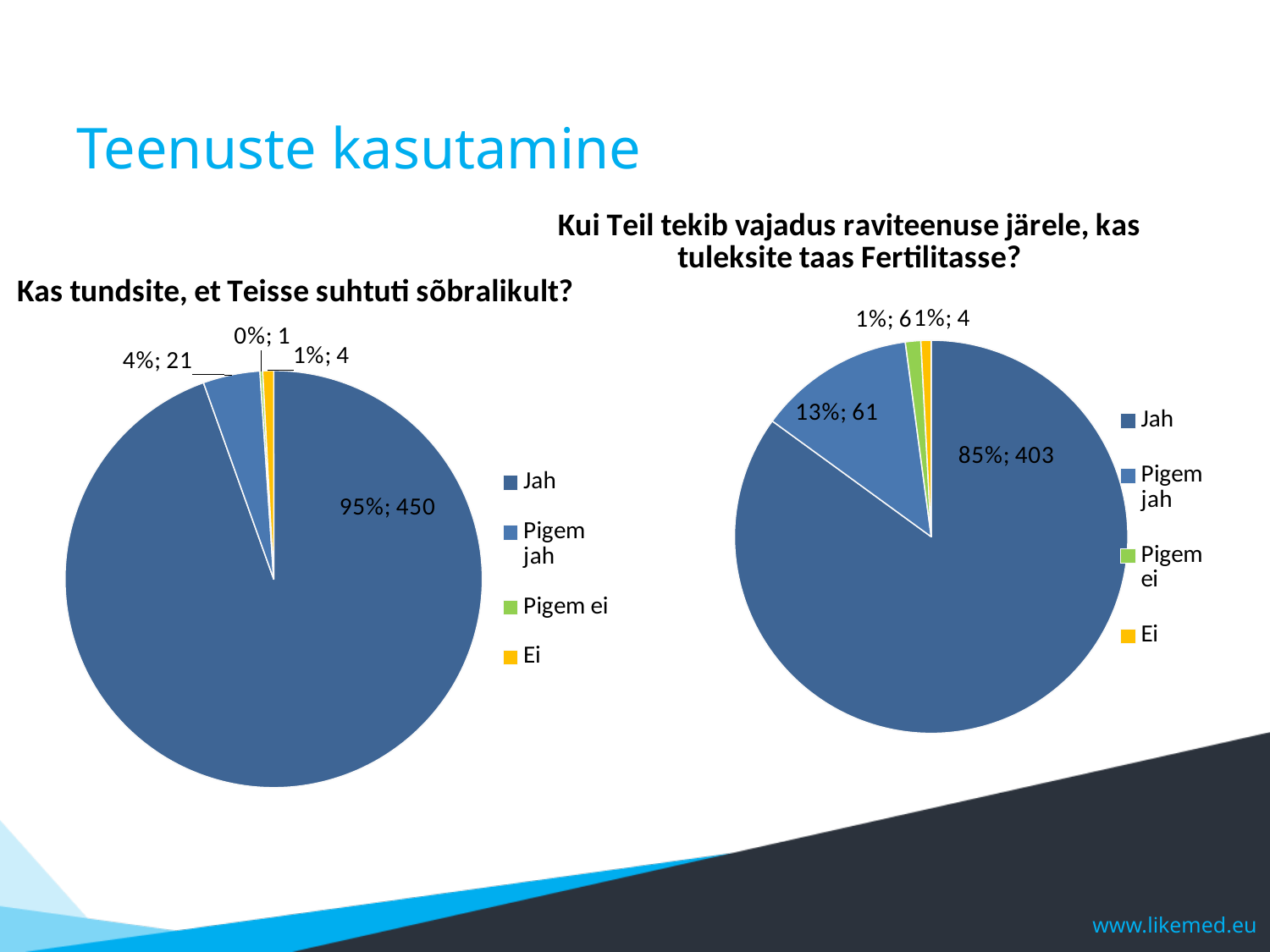
In the right pie chart ("Kui Teil tekib vajadus raviteenuse järele, kas tuleksite taas Fertilitasse?"), which category has the largest slice? Jah What type of chart is used on this slide? Pie chart Which is larger: the number of "Pigem jah" responses in the left pie chart or in the right pie chart? Right pie chart (61) In the left pie chart ("Kas tundsite, et Teisse suhtuti sõbralikult?"), what share of responses is "Jah"? 95% In the right pie chart ("Kui Teil tekib vajadus raviteenuse järele, kas tuleksite taas Fertilitasse?"), how many respondents answered "Pigem ei"? 6 In the left pie chart ("Kas tundsite, et Teisse suhtuti sõbralikult?"), how many respondents answered "Pigem jah"? 21 In the left pie chart ("Kas tundsite, et Teisse suhtuti sõbralikult?"), how many respondents answered "Ei"? 4 What is the difference between the number of "Jah" responses in the left pie chart and the number of "Jah" responses in the right pie chart? 47 How many categories does the legend of the left pie chart list? 4 In the right pie chart ("Kui Teil tekib vajadus raviteenuse järele, kas tuleksite taas Fertilitasse?"), how many respondents answered "Jah"? 403 In the left pie chart ("Kas tundsite, et Teisse suhtuti sõbralikult?"), which category has the smallest slice? Pigem ei In the right pie chart ("Kui Teil tekib vajadus raviteenuse järele, kas tuleksite taas Fertilitasse?"), what share of responses is "Pigem jah"? 13%